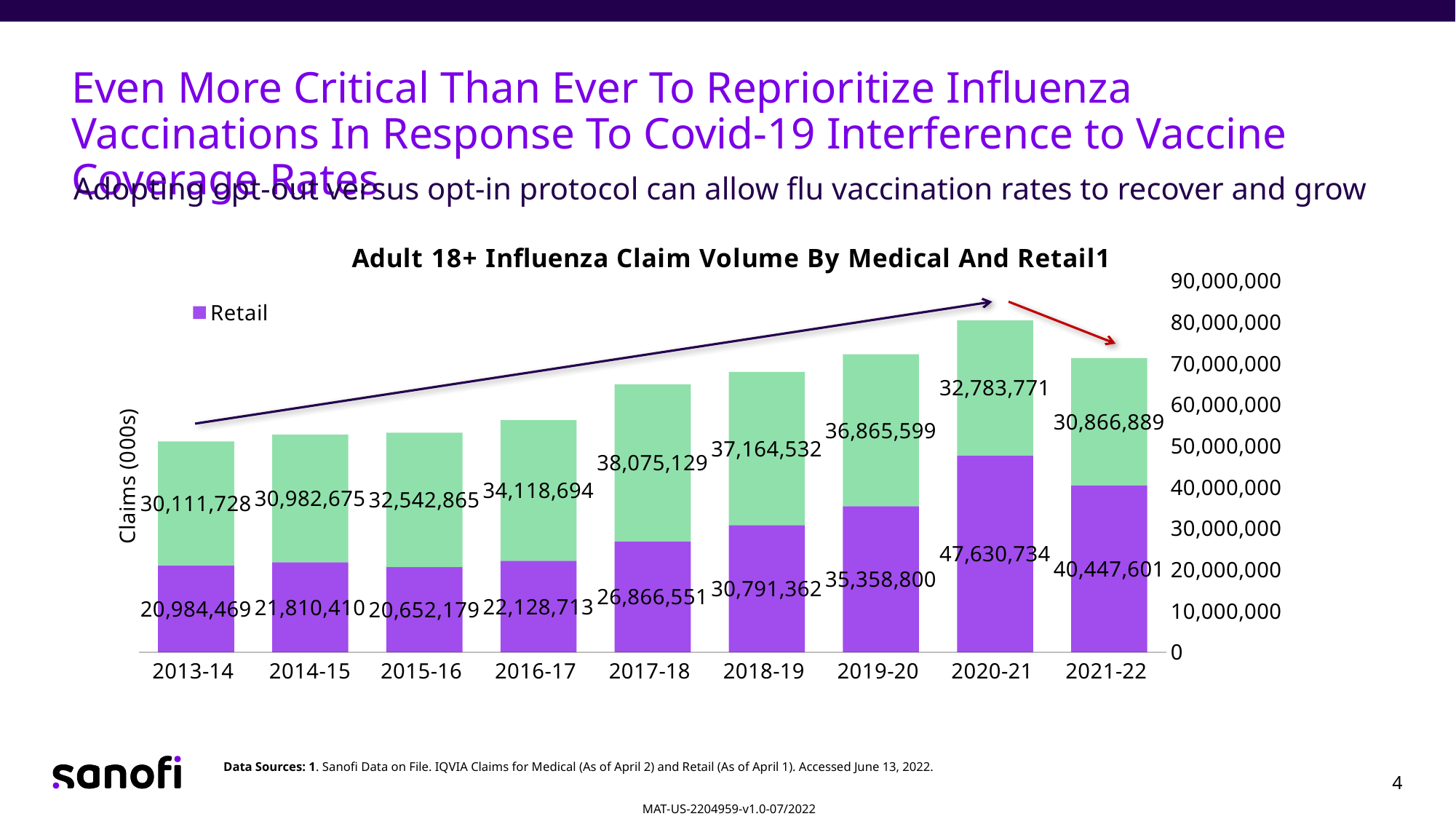
Which season has the lowest Retail value? 2015-16 Which is larger, the Retail value for 2018-19 or for 2019-20? 2019-20 How many seasons are shown on the x axis? 9 Which season has the highest Retail value? 2020-21 Does the Retail value rise or fall from 2016-17 to 2020-21? Rise What is the total of the stacked bar for 2020-21? 80,414,505 What is the Retail value for 2013-14? 20,984,469 What is the difference between the Retail values for 2020-21 and 2021-22? 7,183,133 What is the title of the chart? Adult 18+ Influenza Claim Volume By Medical And Retail1 What kind of chart is shown on the slide? Stacked bar chart What is the Retail value for 2020-21? 47,630,734 What is the value of the upper (green) segment for 2017-18? 38,075,129